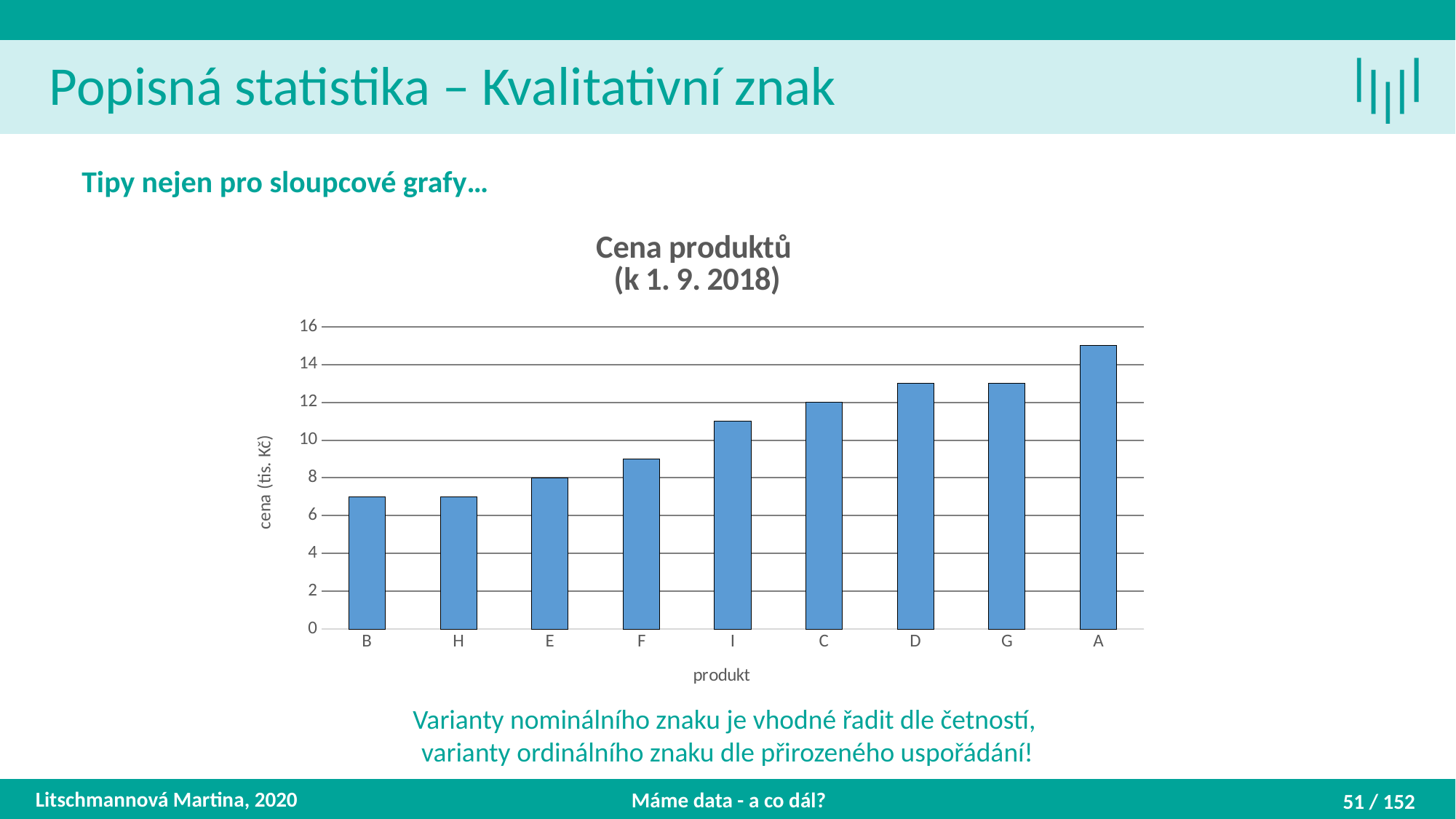
What is the value for product C? 12 Is the value for product A greater or less than 14? greater What is the title of the chart? Cena produktů (k 1. 9. 2018) What is the value for product E? 8 Is the value for product I greater or less than 10? greater What kind of chart is shown on the slide? bar chart Do the values generally rise or fall from left to right along the x axis? rise Which is larger, the value for product D or the value for product F? D What is the label of the vertical axis of the chart? cena (tis. Kč) How many products are shown on the x axis of the chart? 9 Which product has the highest price in the chart? A Is the value for product B greater or less than 8? less